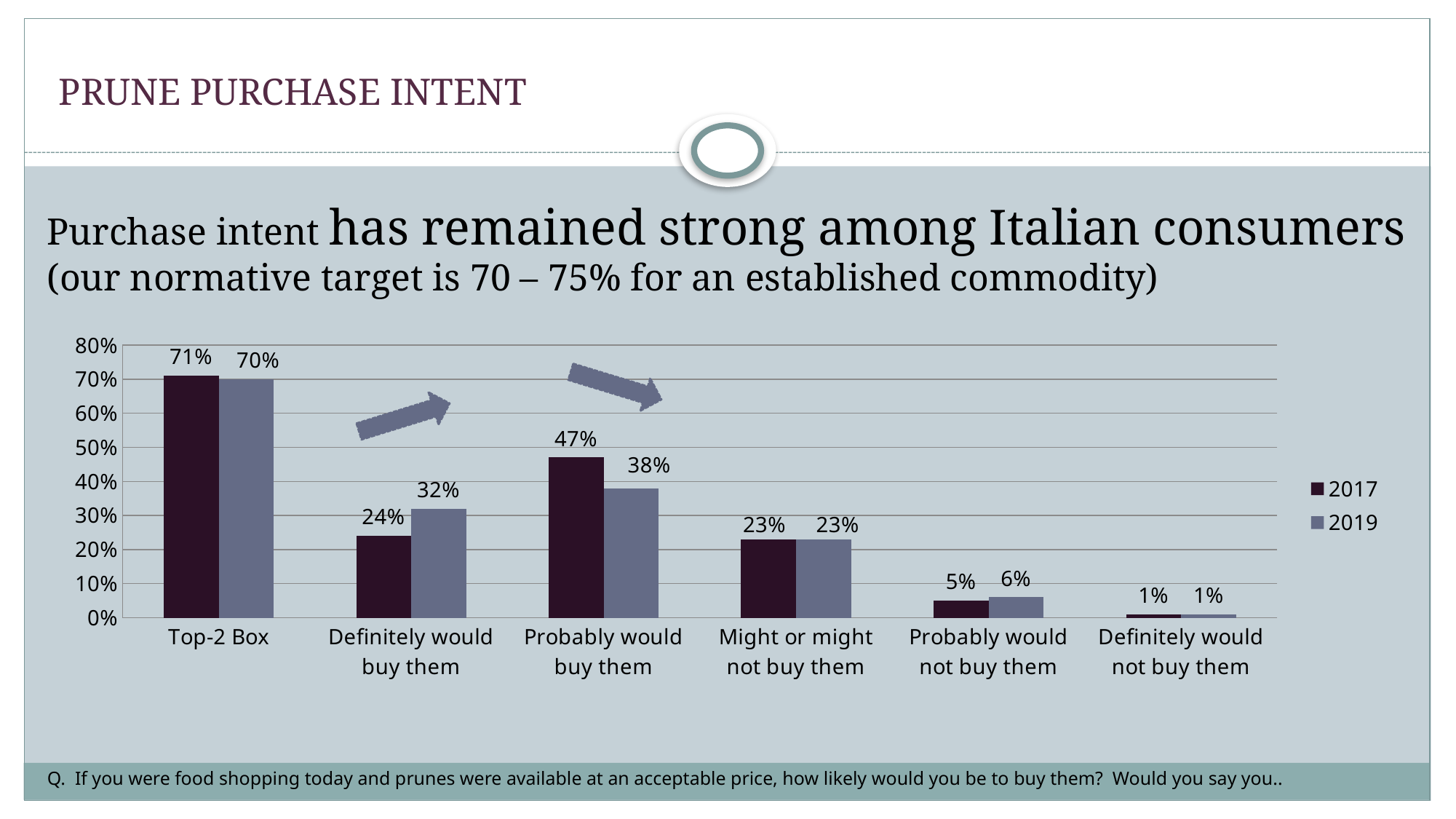
Which category has the lowest 2017 value? Definitely would not buy them Which series is shown in the darker colour in the legend? 2017 What is the 2017 value for Probably would buy them? 47% Which category has the highest 2019 value? Top-2 Box What is the 2017 value for Top-2 Box? 71% What kind of chart is shown on the slide? Bar chart What is the 2019 value for Definitely would buy them? 32% Which is larger for Definitely would buy them, the 2017 value or the 2019 value? 2019 How many categories are shown on the x axis? 6 What is the 2019 value for Probably would not buy them? 6% How many series does the legend list? 2 What is the difference between the 2017 and 2019 values for Probably would buy them? 9%